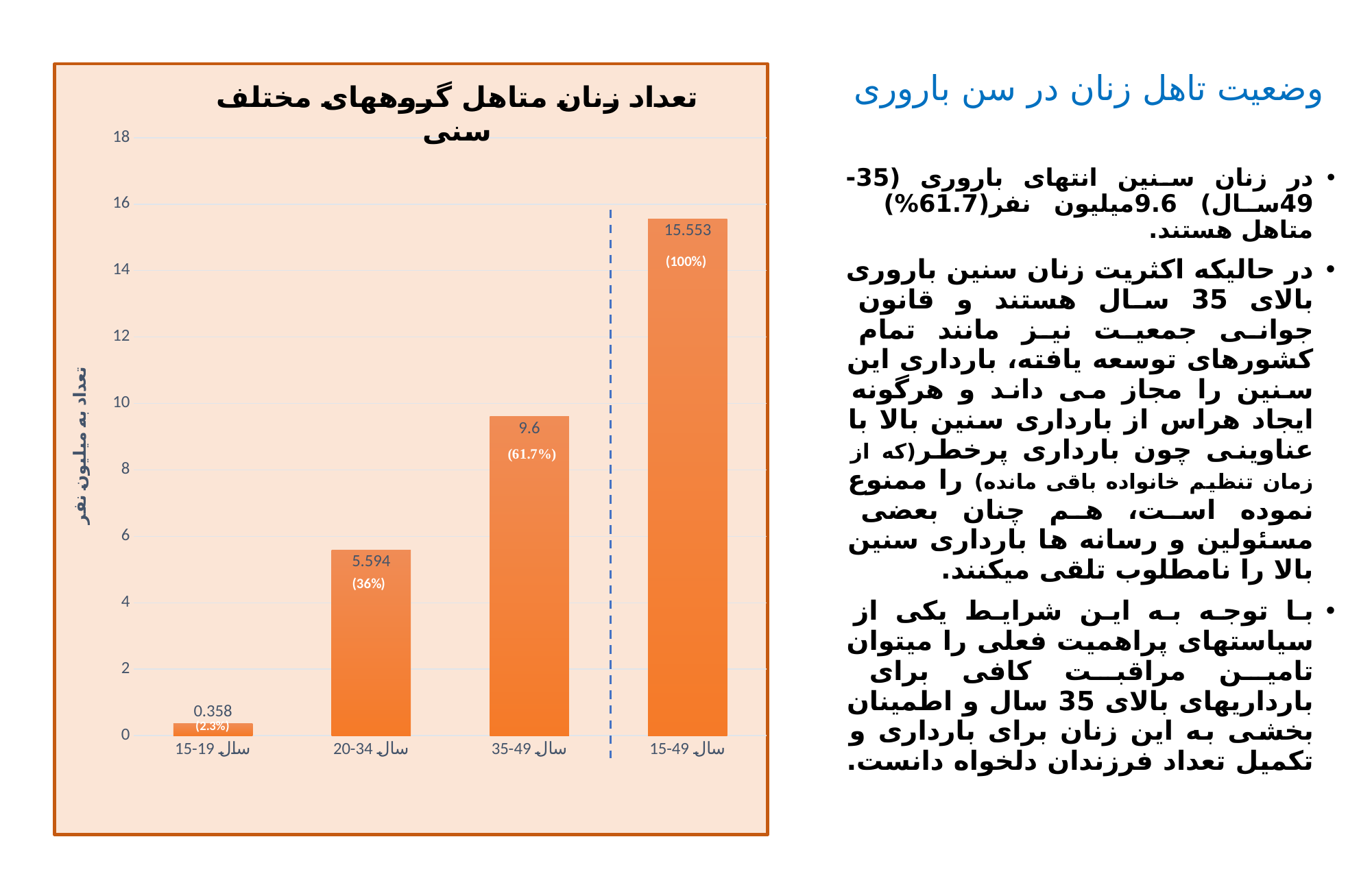
What value is shown for the 20-34 سال age group? 5.594 What value is shown for the 15-49 سال group? 15.553 What kind of chart is shown on the slide? Bar chart Which is larger, the value for 20-34 سال or the value for 35-49 سال? 35-49 سال How many bars are shown in the chart? 4 Which age group has the lowest value? 15-19 سال What is the label of the vertical axis? تعداد به میلیون نفر What is the difference between the values for 35-49 سال and 20-34 سال? 4.006 What percentage is printed on the bar for the 35-49 سال age group? 61.7% What value is shown for the 35-49 سال age group? 9.6 Which category has the highest value? 15-49 سال What value is shown for the 15-19 سال age group? 0.358